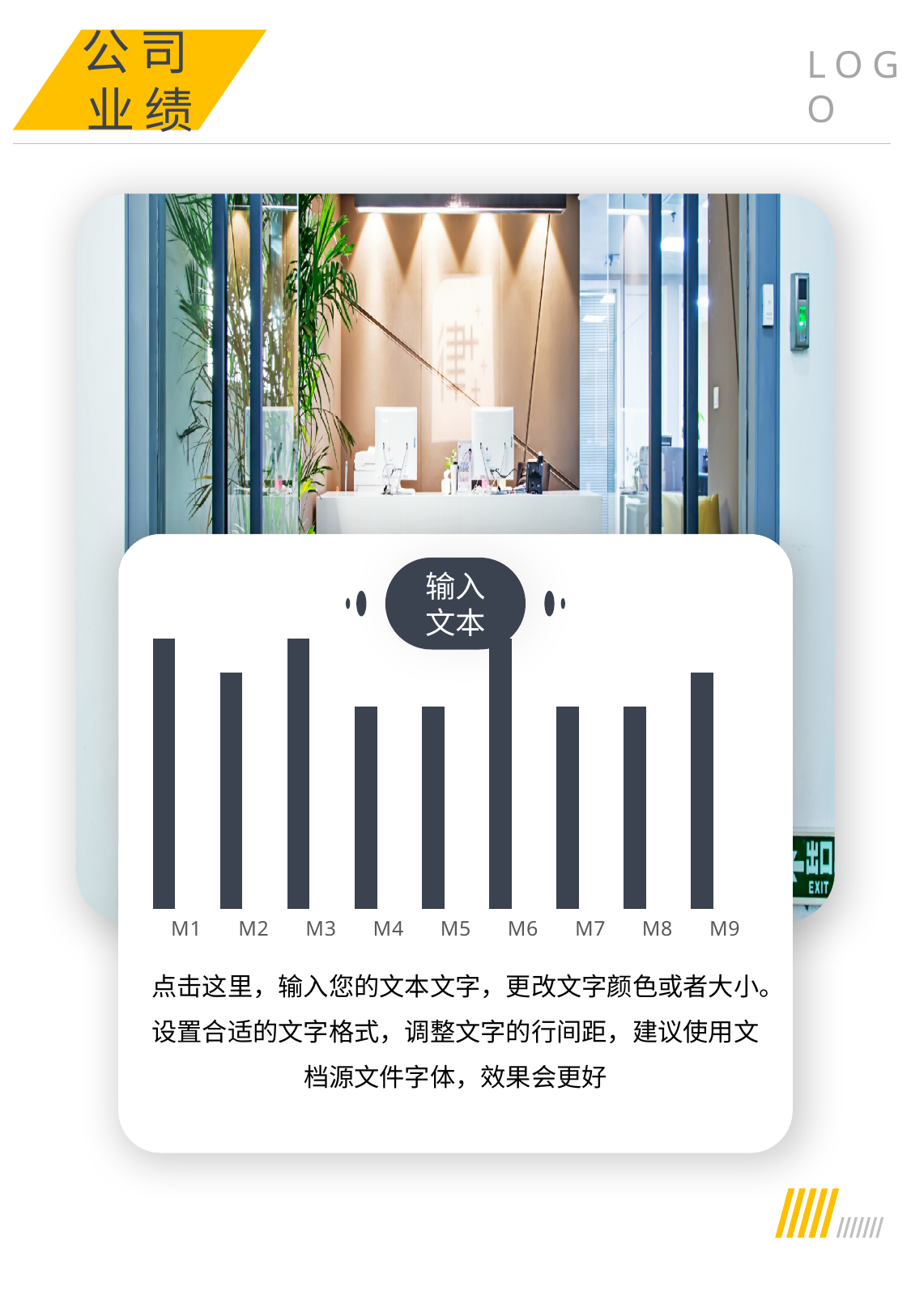
How many categories are shown on the x axis of the bar chart? 9 What kind of chart is shown on the slide? bar chart What is the label of the first category on the x axis? M1 Which bar is taller, M2 or M4? M2 Which category has the tallest bar in the chart? M1, M3 and M6 (tied) What is the label of the last category on the x axis? M9 Which bar is taller, M9 or M7? M9 Which bar is taller, M6 or M9? M6